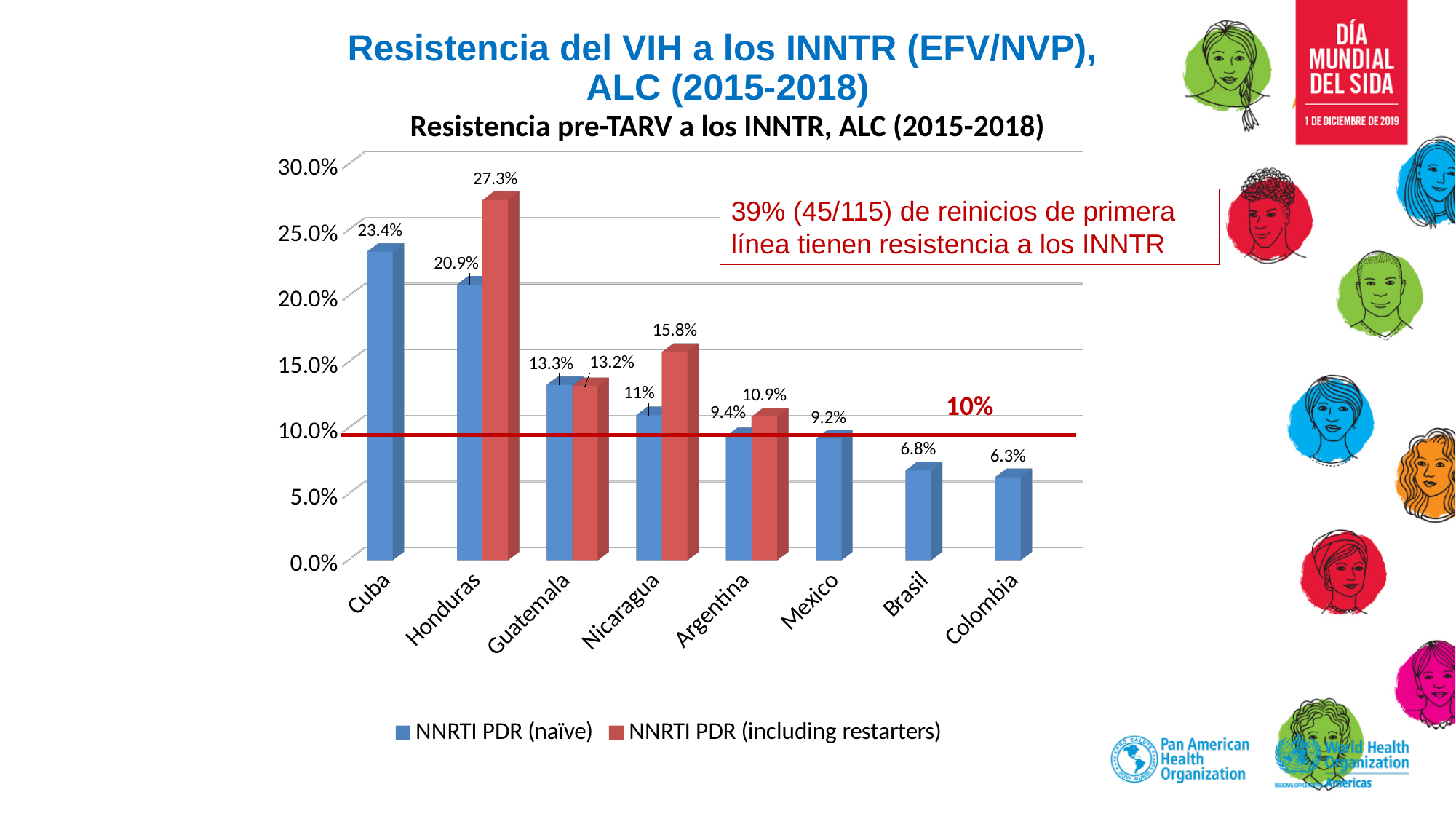
How many countries are shown on the x axis of the chart? 8 What kind of chart is shown on the slide? Bar chart What is the NNRTI PDR (including restarters) value for Honduras? 27.3% Which country has the lowest NNRTI PDR (naïve) value? Colombia What is the difference between the NNRTI PDR (including restarters) and NNRTI PDR (naïve) values for Honduras? 6.4 percentage points Do the NNRTI PDR (naïve) values rise or fall from Cuba to Colombia along the x axis? Fall What is the NNRTI PDR (naïve) value for Cuba? 23.4% How many series does the chart legend list? 2 What is the NNRTI PDR (naïve) value for Nicaragua? 11% Which is larger for Nicaragua: the NNRTI PDR (naïve) value or the NNRTI PDR (including restarters) value? NNRTI PDR (including restarters) Which country has the highest NNRTI PDR (naïve) value? Cuba Is the NNRTI PDR (naïve) value for Mexico greater or less than 10%? less